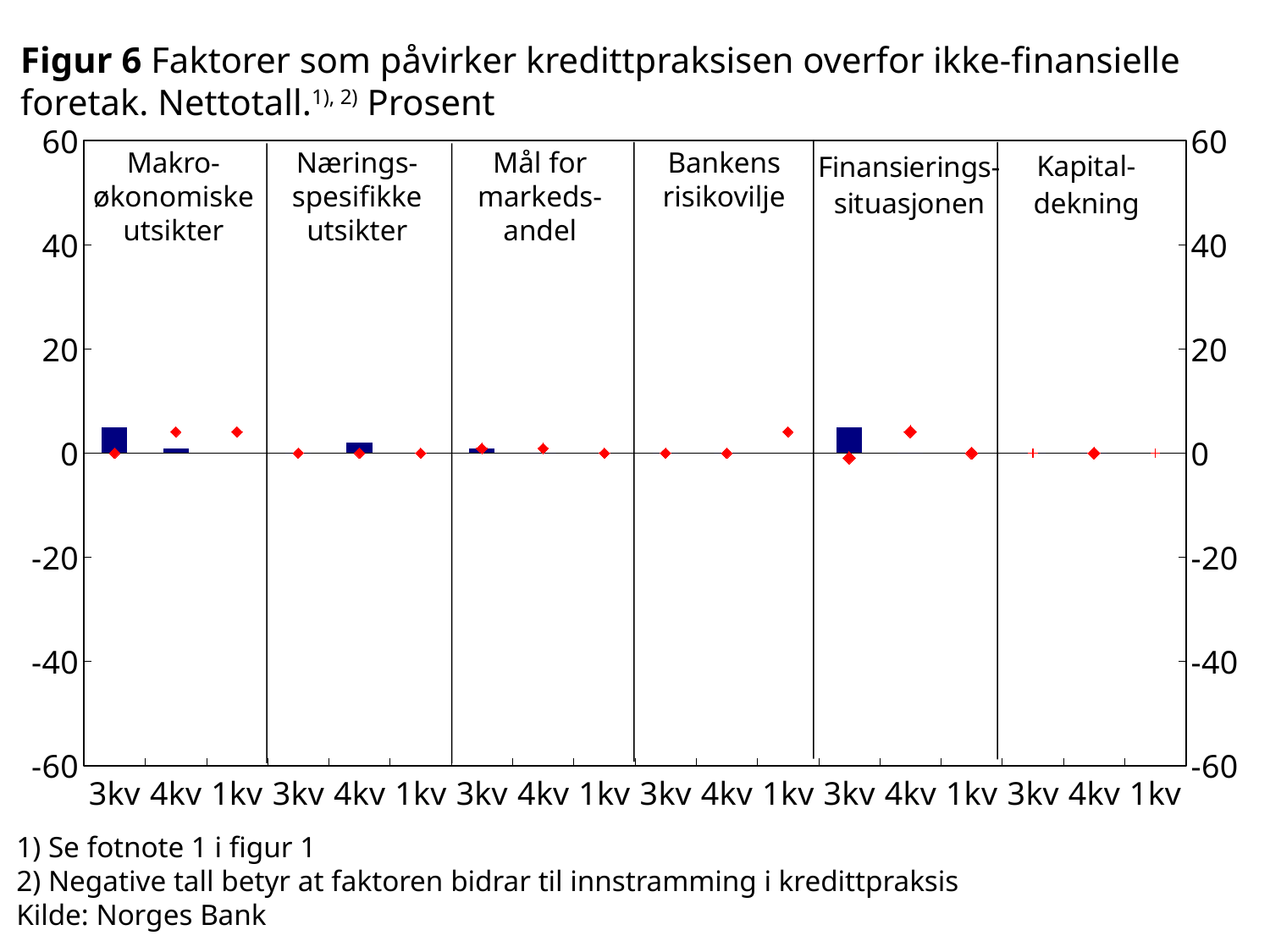
Under Makroøkonomiske utsikter, which bar is larger: 3kv or 4kv? 3kv What is the highest value shown on the vertical axis? 60 Is the bar for 4kv under Næringsspesifikke utsikter greater or less than 20? less Under Næringsspesifikke utsikter, which bar is larger: 3kv or 4kv? 4kv How many factor panels are shown in the chart? 6 Is the bar for 3kv under Makroøkonomiske utsikter greater or less than 0? greater What kind of chart is shown in Figur 6? combination bar and line chart What is the lowest value shown on the vertical axis? -60 Which factor panel is furthest to the right in the chart? Kapitaldekning Is the bar for 3kv under Makroøkonomiske utsikter greater or less than 20? less How many quarters are shown within each factor panel? 3